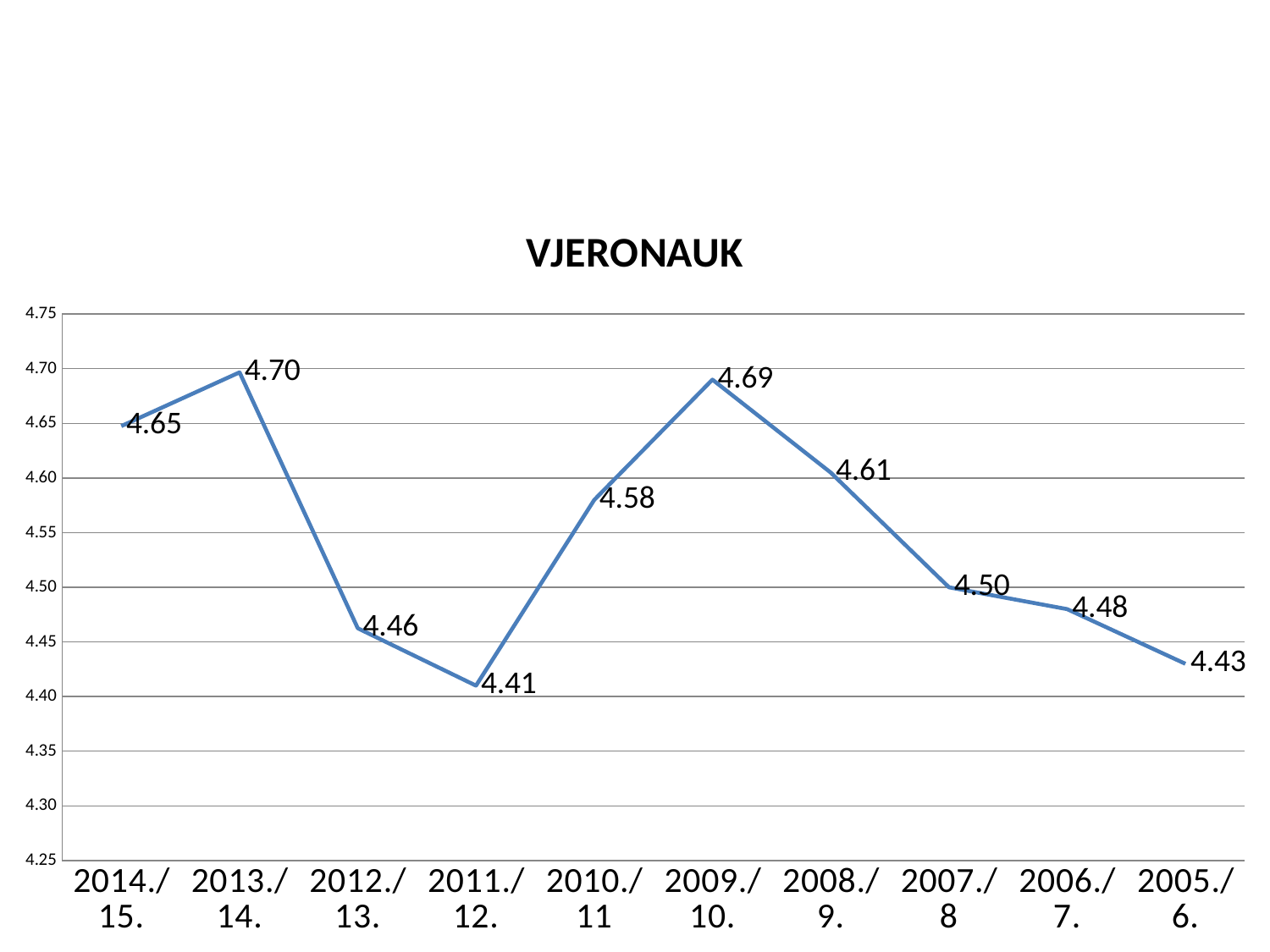
What is the value for 2008./9.? 4.61 Which category has the highest value? 2013./14. Is the value for 2009./10. greater or less than 4.65? greater Which category has the lowest value? 2011./12. What is the difference between the values for 2013./14. and 2012./13.? 0.24 What is the title of the chart? VJERONAUK What is the value for 2005./6.? 4.43 Which is larger, the value for 2010./11 or the value for 2007./8? 2010./11 What is the value for 2011./12.? 4.41 How many categories are shown on the x axis? 10 What is the value for 2014./15.? 4.65 What kind of chart is this? line chart